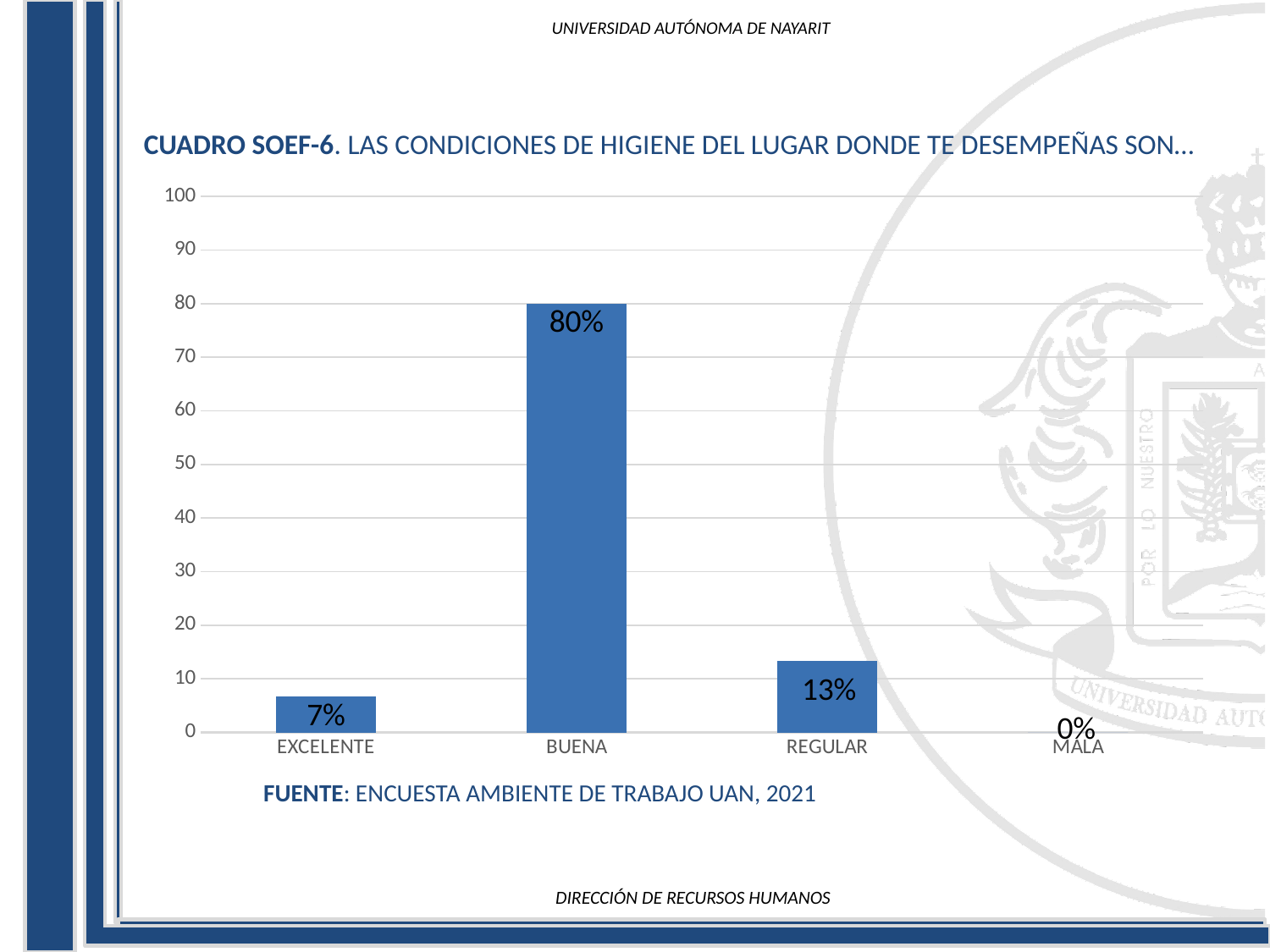
What is the value for BUENA? 80% What kind of chart is shown on the slide? bar chart Which category has the highest value? BUENA What is the value for REGULAR? 13% What is the value for EXCELENTE? 7% Which is larger, the value for EXCELENTE or the value for REGULAR? REGULAR Is the value for BUENA greater or less than 50? greater How many categories are shown on the x axis? 4 Which category has the lowest value? MALA What is the value for MALA? 0% What is the difference between the values for BUENA and REGULAR? 67% What is the difference between the values for REGULAR and EXCELENTE? 6%